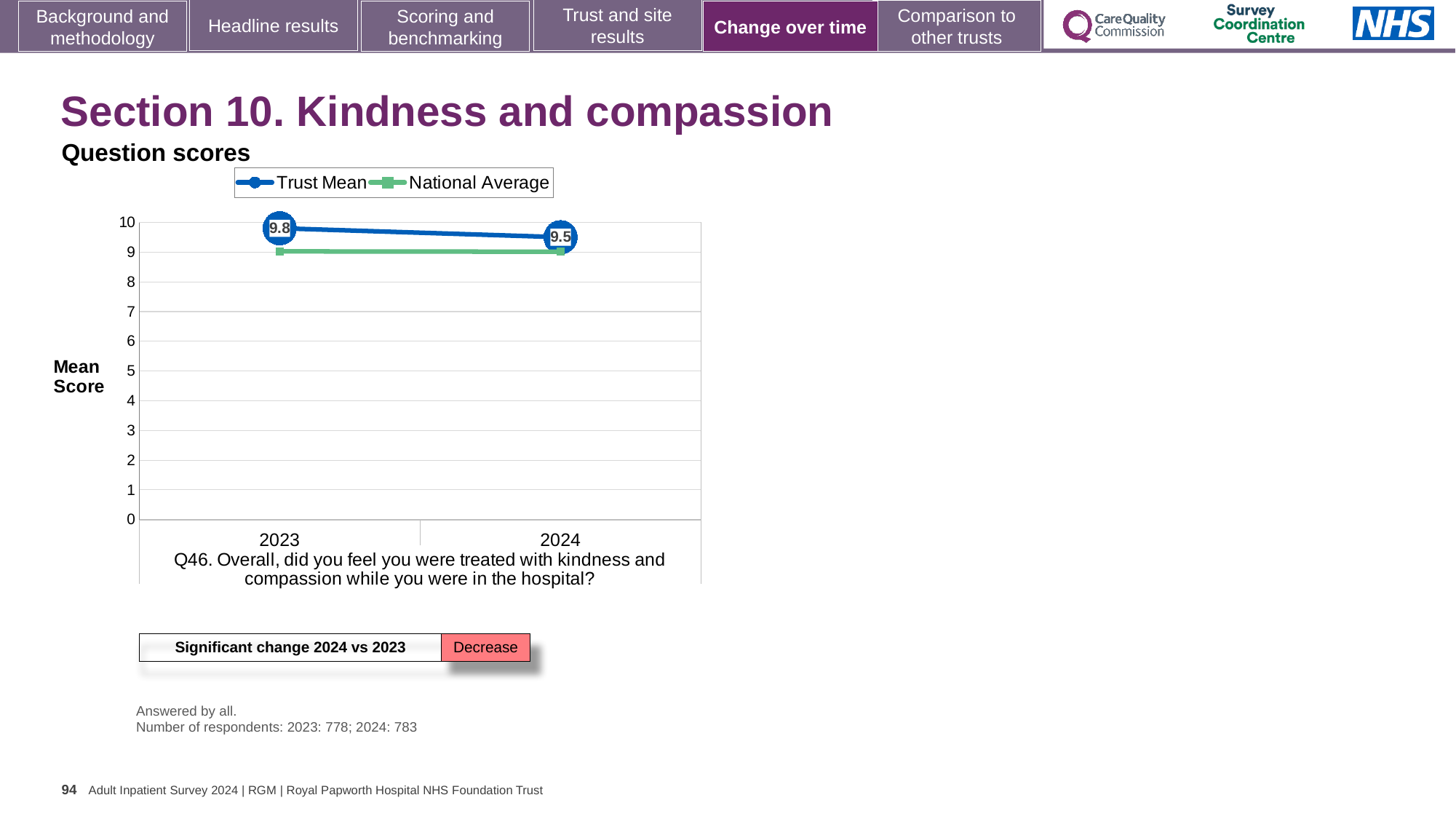
Does the Trust Mean line rise or fall from 2023 to 2024? fall Is the National Average value for 2023 greater or less than 8? greater In 2024, which is higher, the Trust Mean or the National Average? Trust Mean What is the Trust Mean score for 2023? 9.8 By how much did the Trust Mean score change from 2023 to 2024? 0.3 Which year has the higher Trust Mean score, 2023 or 2024? 2023 What is the Trust Mean score for 2024? 9.5 How many series does the legend list? 2 How many years are plotted on the x axis? 2 What is the label on the y axis of the chart? Mean Score What are the two series named in the legend? Trust Mean and National Average What kind of chart is shown on the slide? line chart